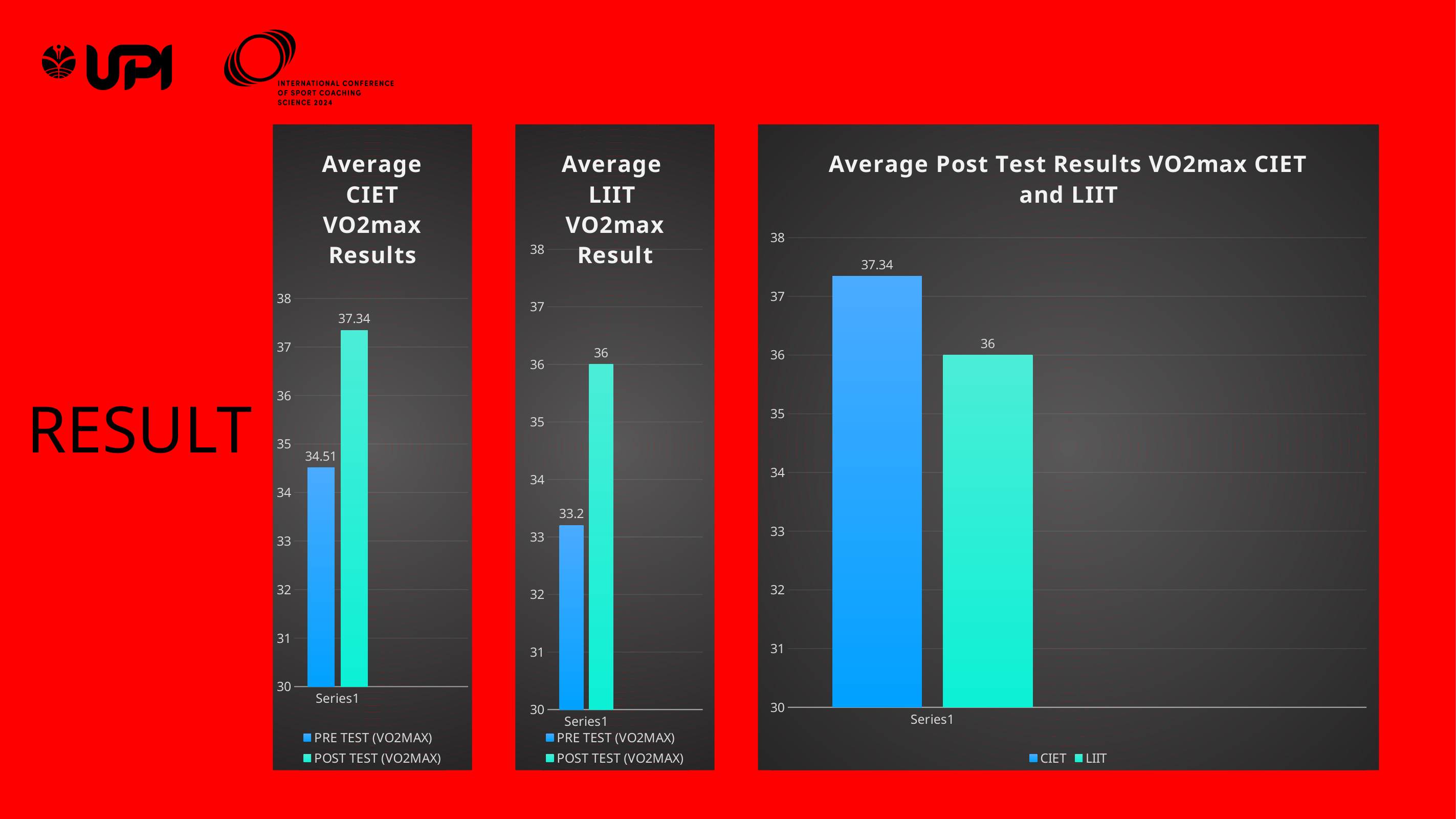
In the 'Average CIET VO2max Results' chart, what is the value for PRE TEST (VO2MAX)? 34.51 In the 'Average Post Test Results VO2max CIET and LIIT' chart, what is the value for LIIT? 36 In the 'Average LIIT VO2max Result' chart, what is the difference between the POST TEST and PRE TEST values? 2.8 How many series does the legend of the 'Average Post Test Results VO2max CIET and LIIT' chart list? 2 What kind of chart is the 'Average Post Test Results VO2max CIET and LIIT' chart? bar chart In the 'Average Post Test Results VO2max CIET and LIIT' chart, which group has the higher value? CIET In the 'Average CIET VO2max Results' chart, what is the difference between the POST TEST and PRE TEST values? 2.83 In the 'Average Post Test Results VO2max CIET and LIIT' chart, what is the difference between the CIET and LIIT values? 1.34 In the 'Average LIIT VO2max Result' chart, what is the value for POST TEST (VO2MAX)? 36 In the 'Average LIIT VO2max Result' chart, what is the value for PRE TEST (VO2MAX)? 33.2 In the 'Average CIET VO2max Results' chart, what is the value for POST TEST (VO2MAX)? 37.34 In the 'Average LIIT VO2max Result' chart, is the PRE TEST value greater or less than 34? less